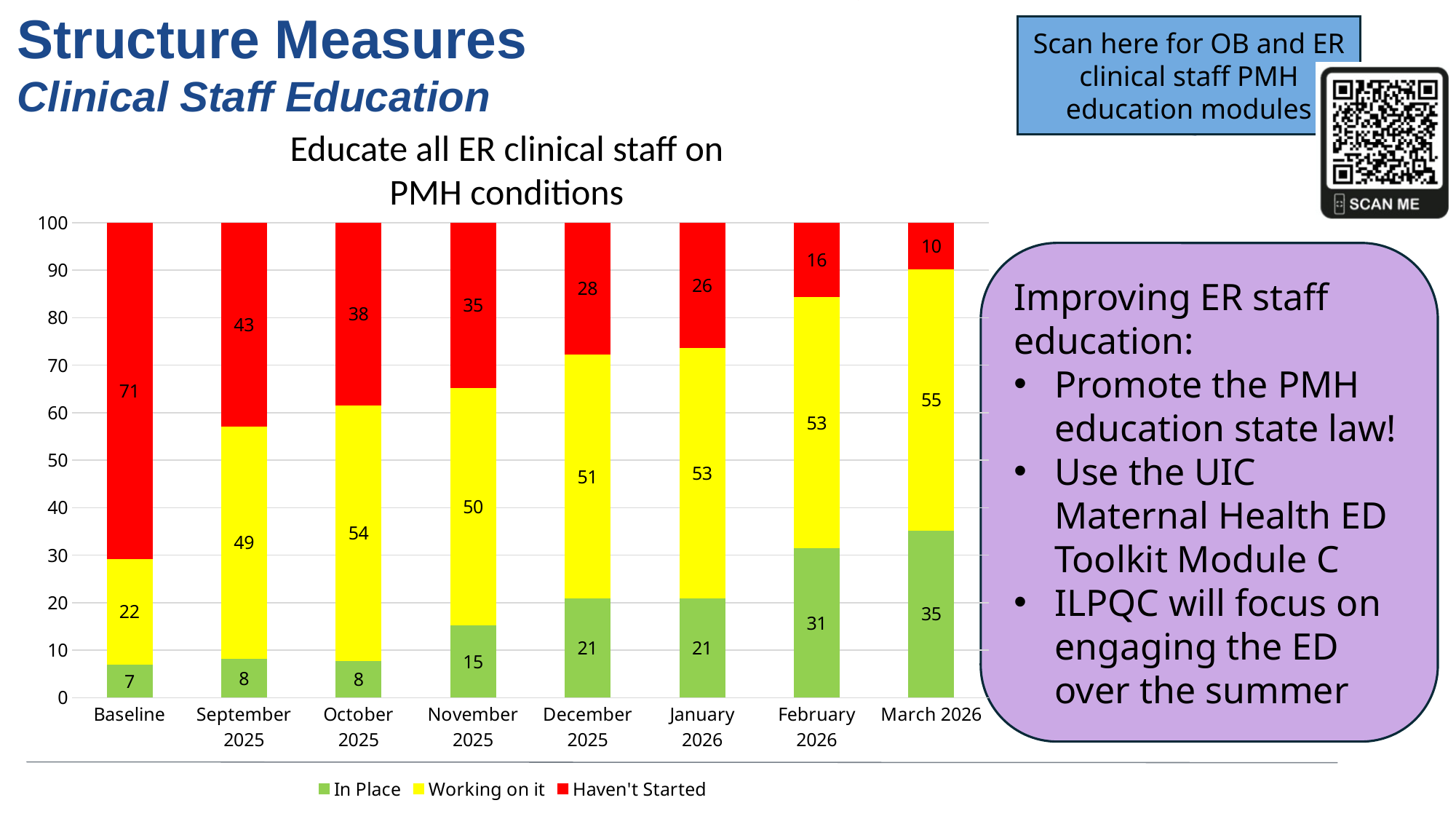
What kind of chart is shown? Stacked bar chart What is the value for "In Place" in March 2026? 35 Which category has the highest "In Place" value? March 2026 What is the difference between the "Haven't Started" values for Baseline and March 2026? 61 How many series does the legend list? 3 What is the value for "Haven't Started" at Baseline? 71 What is the title of the chart? Educate all ER clinical staff on PMH conditions Does the "In Place" value rise or fall from Baseline to March 2026? Rise Which category has the lowest "Haven't Started" value? March 2026 How many categories are shown on the x axis? 8 What is the value for "Working on it" in October 2025? 54 Which is larger, the "In Place" value for February 2026 or for December 2025? February 2026